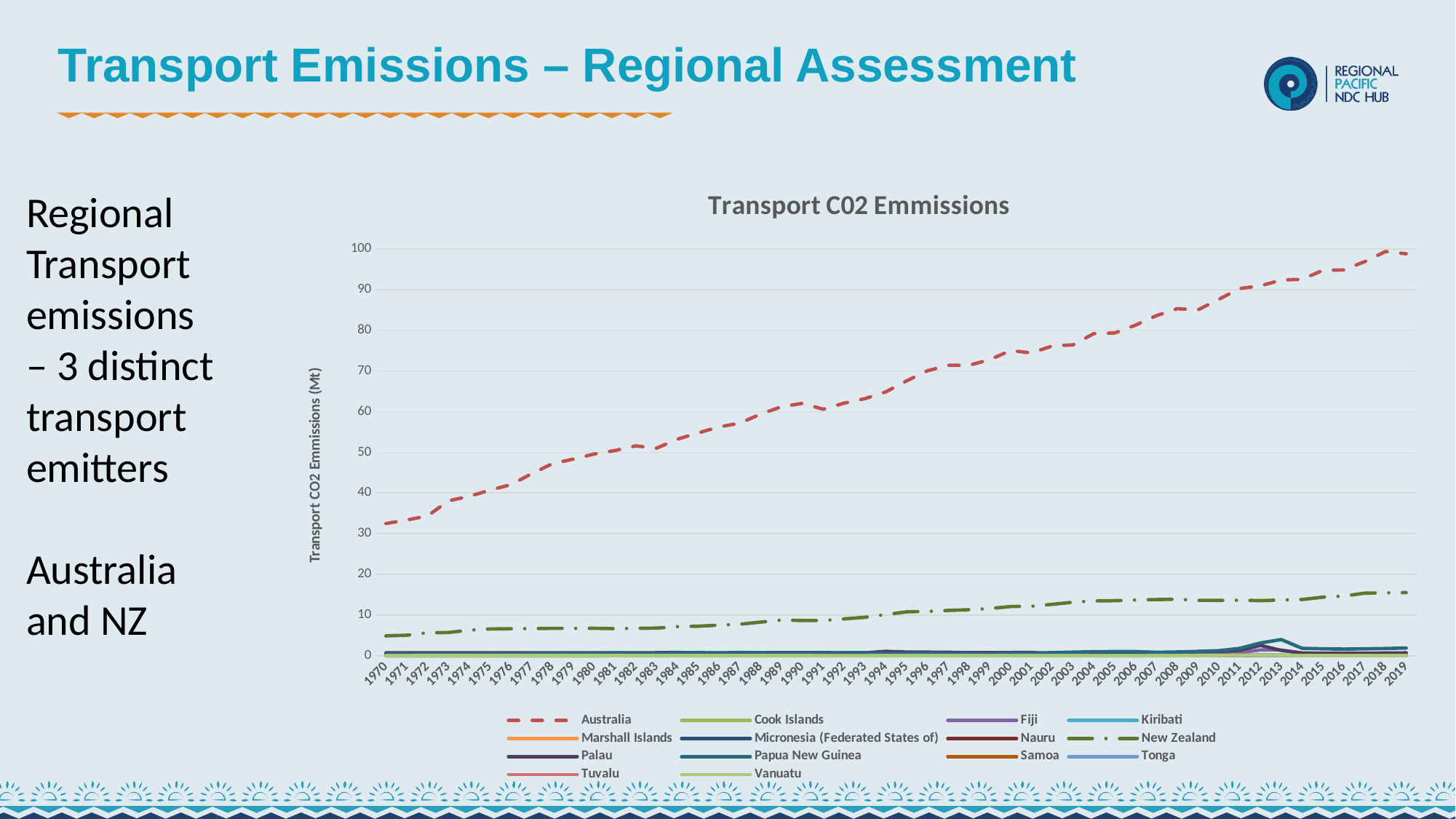
What is the title of the chart? Transport C02 Emmissions Is the value for New Zealand in 1970 greater or less than 10? less Is the value for Australia in 2019 greater or less than 90? greater How many years are shown along the x axis of the chart? 50 How many series does the chart's legend list? 14 Do Australia's transport CO2 emissions rise or fall from 1970 to 2019? rise Is the value for Australia in 2000 greater or less than 70? greater In 2019, which has larger transport CO2 emissions, Australia or New Zealand? Australia What kind of chart is shown on the slide? line chart Which series has the highest transport CO2 emissions throughout the chart? Australia